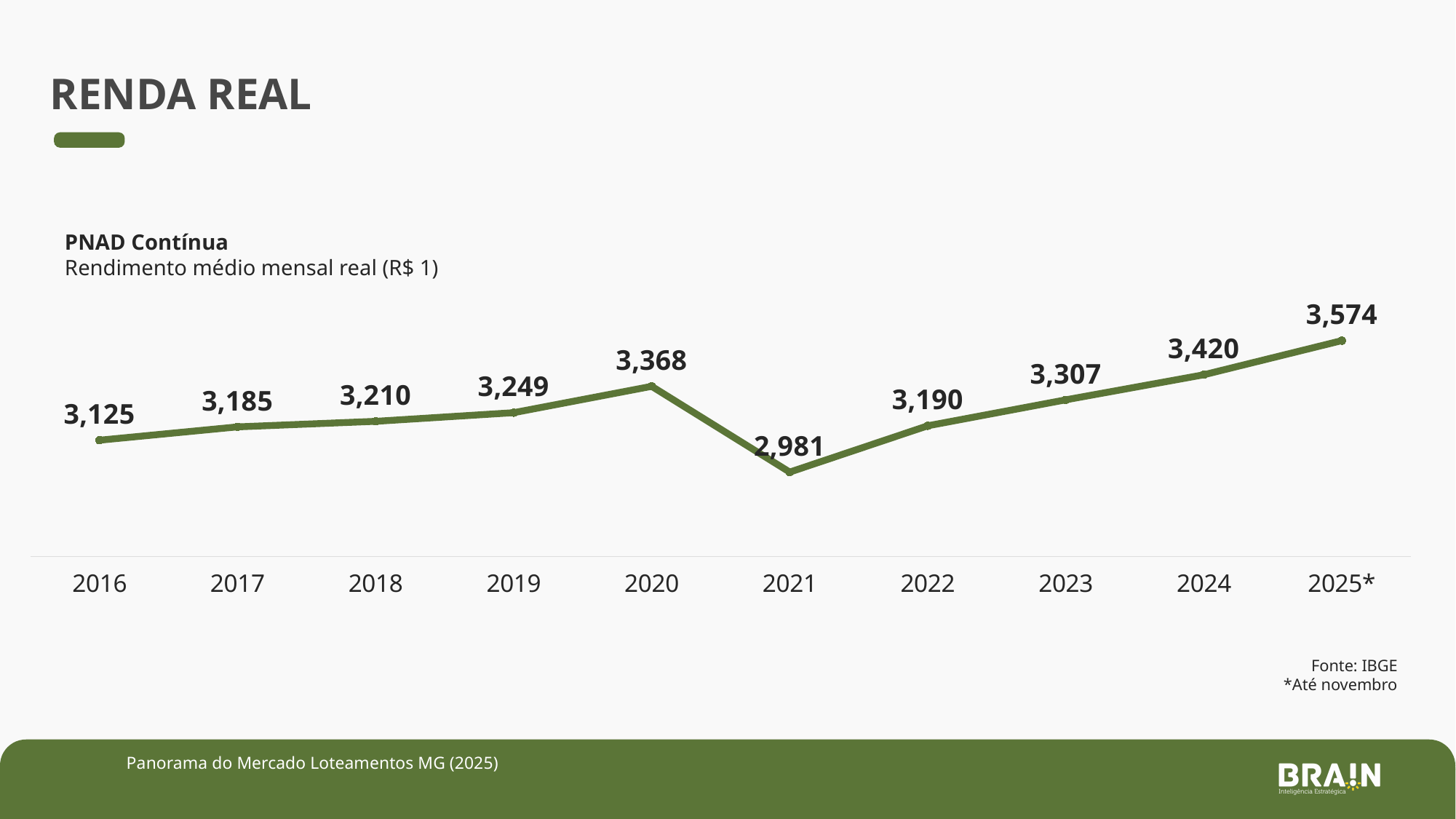
What is the difference between the values for 2025* and 2016? 449 What is the source cited for the chart? IBGE Which is larger, the value for 2019 or the value for 2022? 2019 What is the difference between the values for 2020 and 2021? 387 How many years are plotted on the chart? 10 Which year has the lowest value? 2021 What is the value for 2016? 3,125 What is the value for 2021? 2,981 Do the values rise or fall from 2021 to 2025*? rise Which year has the highest value? 2025* What is the value for 2025*? 3,574 What kind of chart is shown? line chart